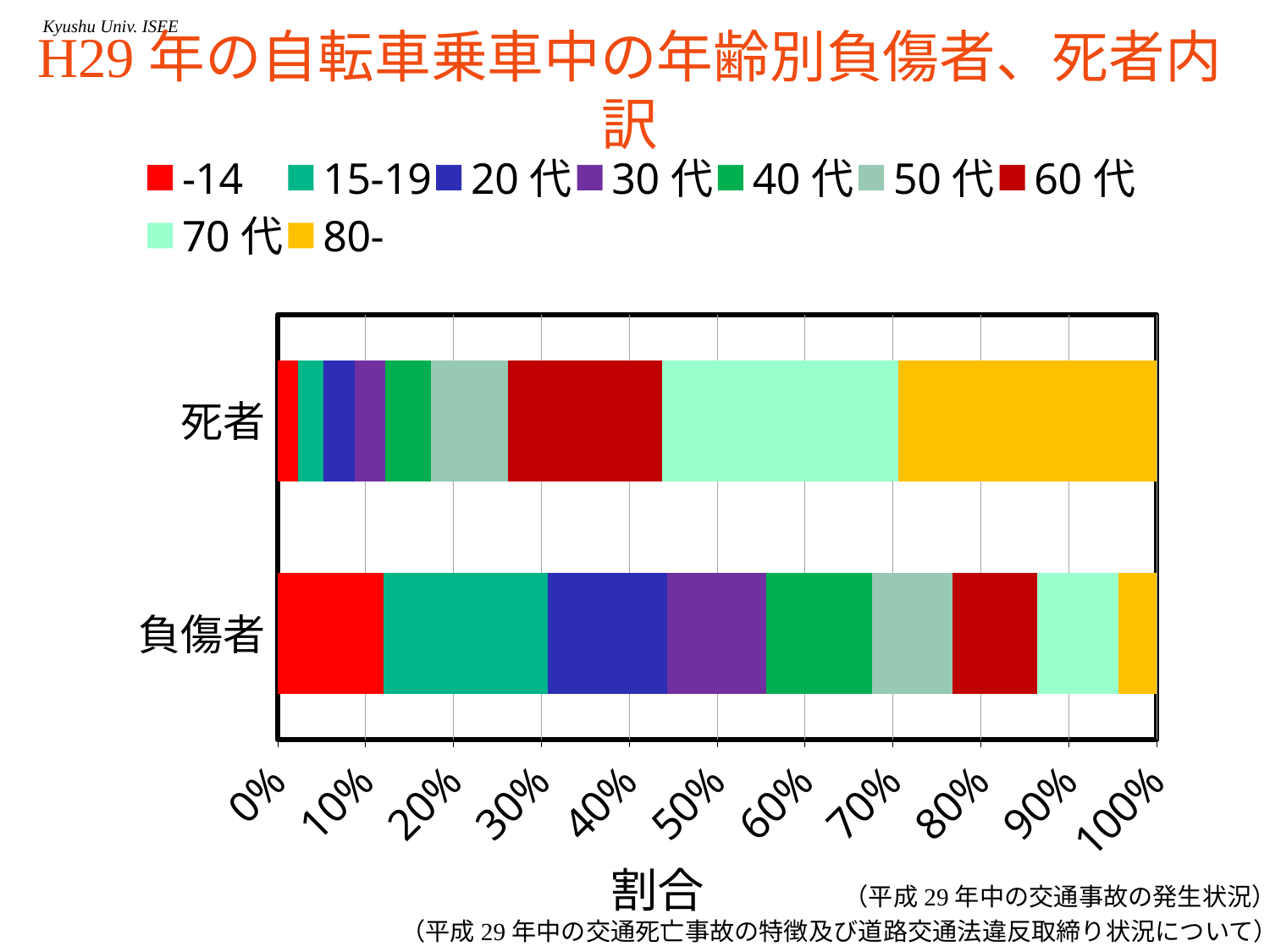
How many series does the legend list? 9 Is the share of the -14 age group in the 死者 bar greater or less than 10%? less What is the label of the horizontal axis? 割合 What are the two categories shown on the vertical axis? 死者 and 負傷者 Which age group has the largest share in the 負傷者 bar? 15-19 What kind of chart is shown on the slide? stacked bar chart Is the share of the 80- age group in the 負傷者 bar greater or less than 10%? less Which bar has the larger share for the 80- age group, 死者 or 負傷者? 死者 Which bar has the larger share for the -14 age group, 死者 or 負傷者? 負傷者 Is the share of the 80- age group in the 死者 bar greater or less than 20%? greater Which age group has the smallest share in the 負傷者 bar? 80- How many bars (categories) does the chart show? 2